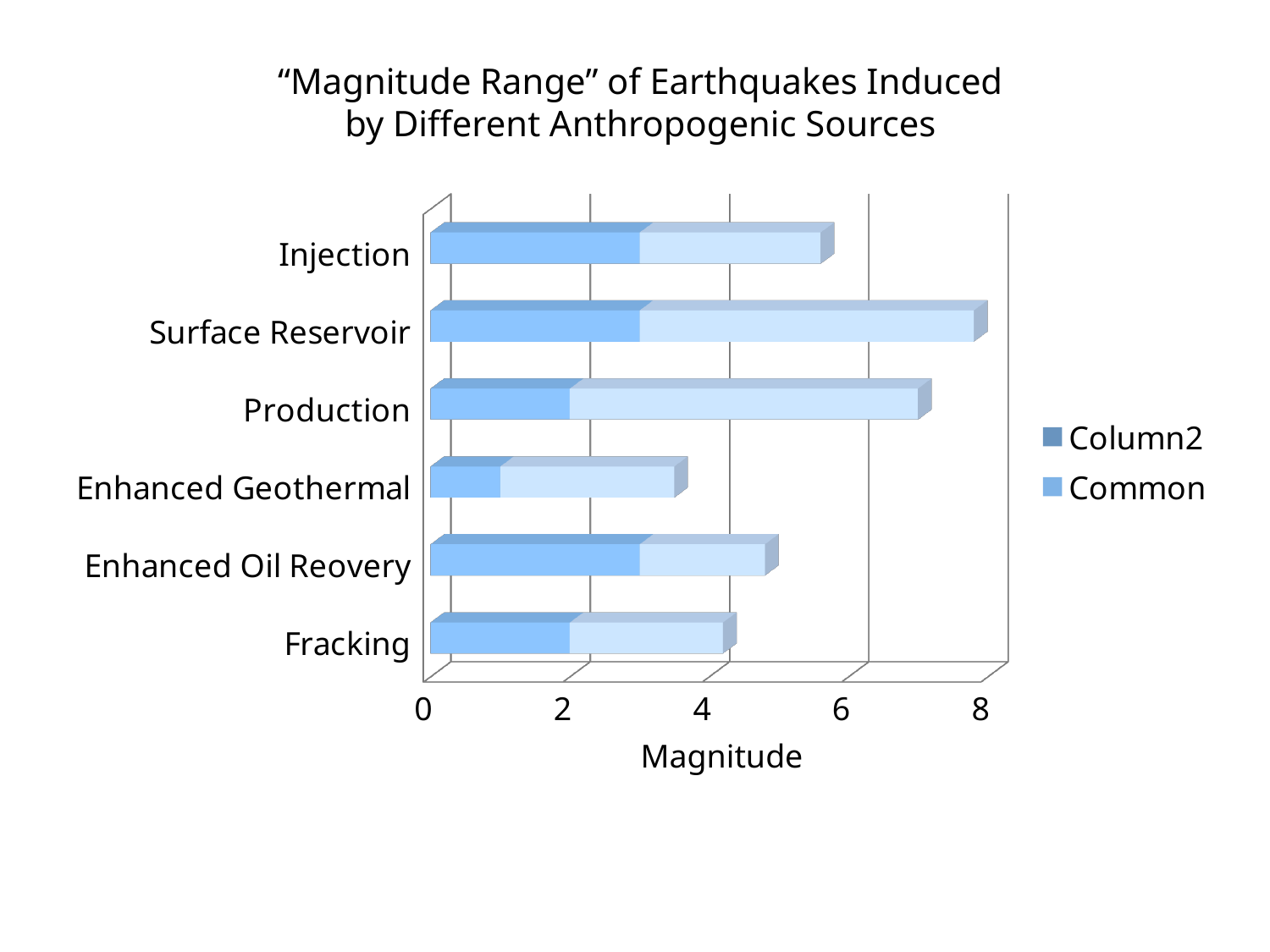
What is the title of the horizontal axis? Magnitude How many anthropogenic sources (categories) are plotted on the chart? 6 Which has the longer total bar, Production or Injection? Production Which source has the longest total bar? Surface Reservoir How many series does the legend list? 2 Is the Column2 segment for Enhanced Geothermal greater or less than 2? less What kind of chart is shown on the slide? bar chart Which has the longer total bar, Enhanced Oil Reovery or Enhanced Geothermal? Enhanced Oil Reovery Is the total bar length for Surface Reservoir greater or less than 6? greater Is the total bar length for Production greater or less than 6? greater Which source has the shortest total bar? Enhanced Geothermal